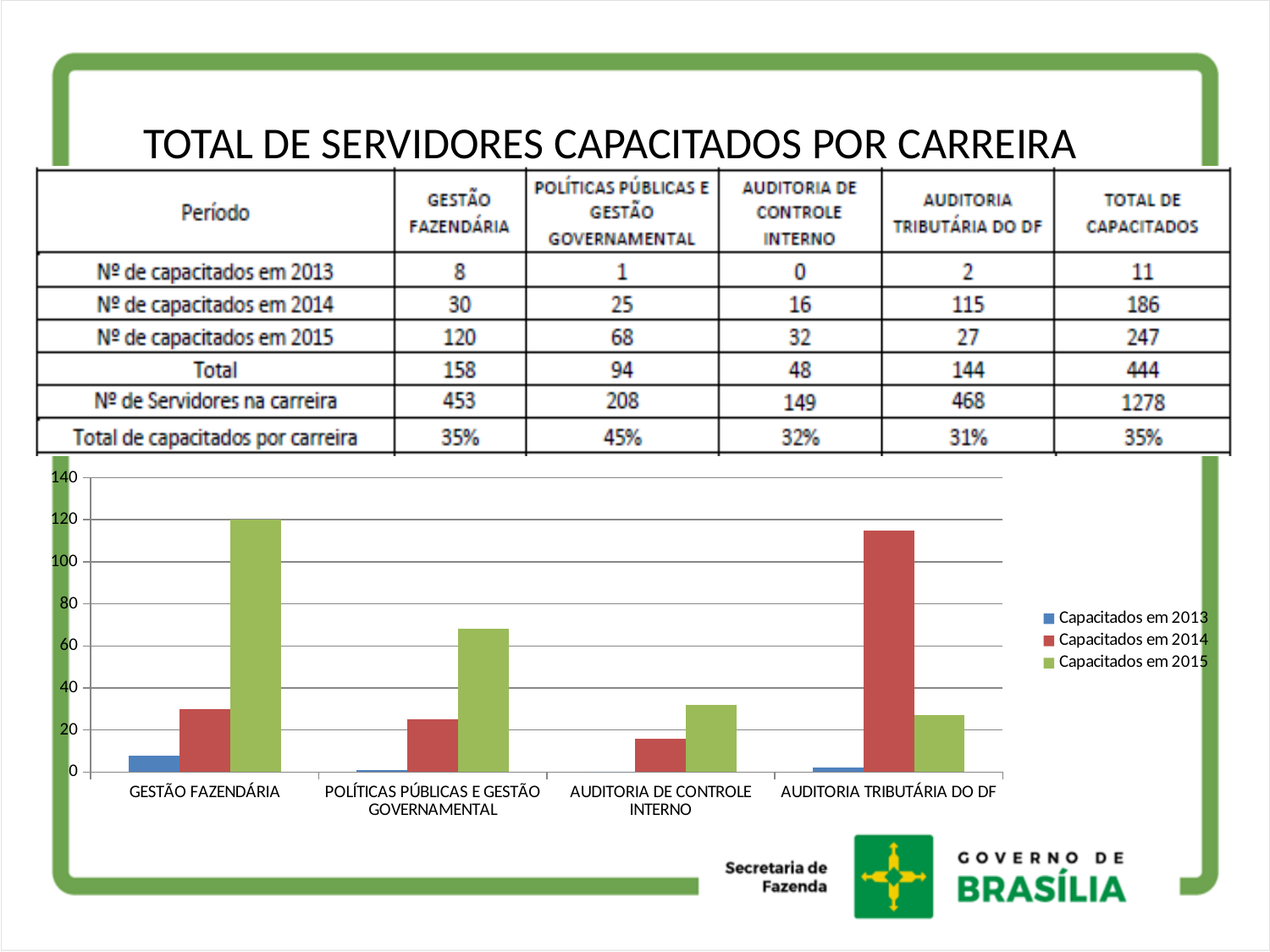
How many series does the chart's legend list? 3 Which category has the lowest bar for Capacitados em 2013? AUDITORIA DE CONTROLE INTERNO What is the value of Capacitados em 2015 for GESTÃO FAZENDÁRIA? 120 Is the value of Capacitados em 2014 for AUDITORIA TRIBUTÁRIA DO DF greater or less than 100? greater What is the value of Capacitados em 2013 for AUDITORIA DE CONTROLE INTERNO? 0 What kind of chart is shown on the slide? bar chart How many career categories are shown on the x axis of the chart? 4 Which category has the tallest bar for Capacitados em 2015? GESTÃO FAZENDÁRIA Which category has the tallest bar for Capacitados em 2014? AUDITORIA TRIBUTÁRIA DO DF What colour represents Capacitados em 2015 in the chart? green Is the value of Capacitados em 2015 for POLÍTICAS PÚBLICAS E GESTÃO GOVERNAMENTAL greater or less than 60? greater For AUDITORIA DE CONTROLE INTERNO, which is larger: Capacitados em 2014 or Capacitados em 2015? Capacitados em 2015